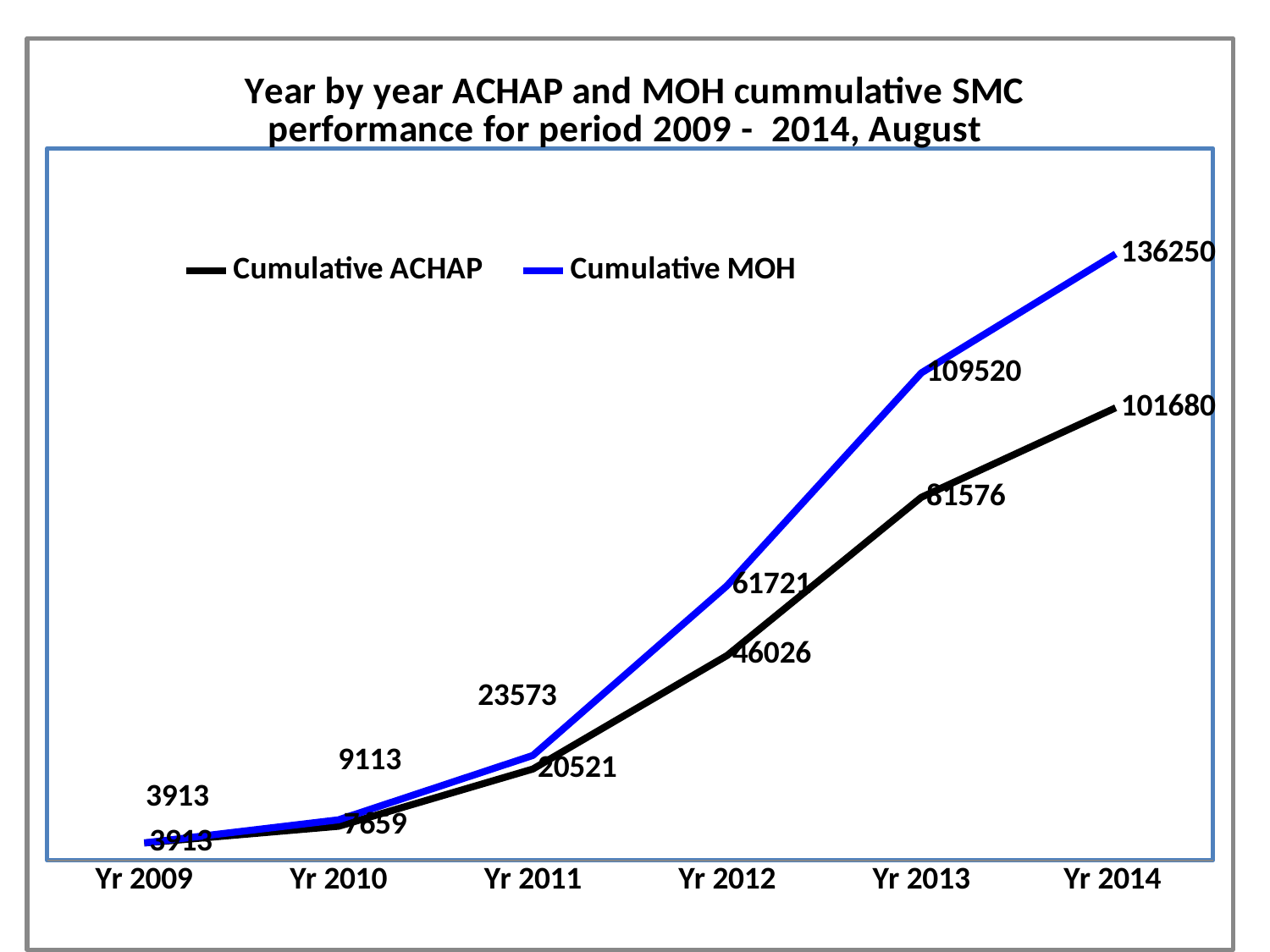
What is the Cumulative MOH value for Yr 2011? 23573 What is the Cumulative MOH value for Yr 2014? 136250 How many series does the legend list? 2 In which year is the Cumulative MOH value highest? Yr 2014 What kind of chart is shown on the slide? Line chart What is the Cumulative ACHAP value for Yr 2013? 81576 What is the Cumulative ACHAP value for Yr 2010? 7659 What is the difference between the Cumulative MOH and Cumulative ACHAP values in Yr 2012? 15695 In which year is the Cumulative ACHAP value lowest? Yr 2009 Which series has the larger value in Yr 2013, Cumulative ACHAP or Cumulative MOH? Cumulative MOH How many years are shown on the x axis? 6 What is the difference between the Cumulative MOH and Cumulative ACHAP values in Yr 2014? 34570